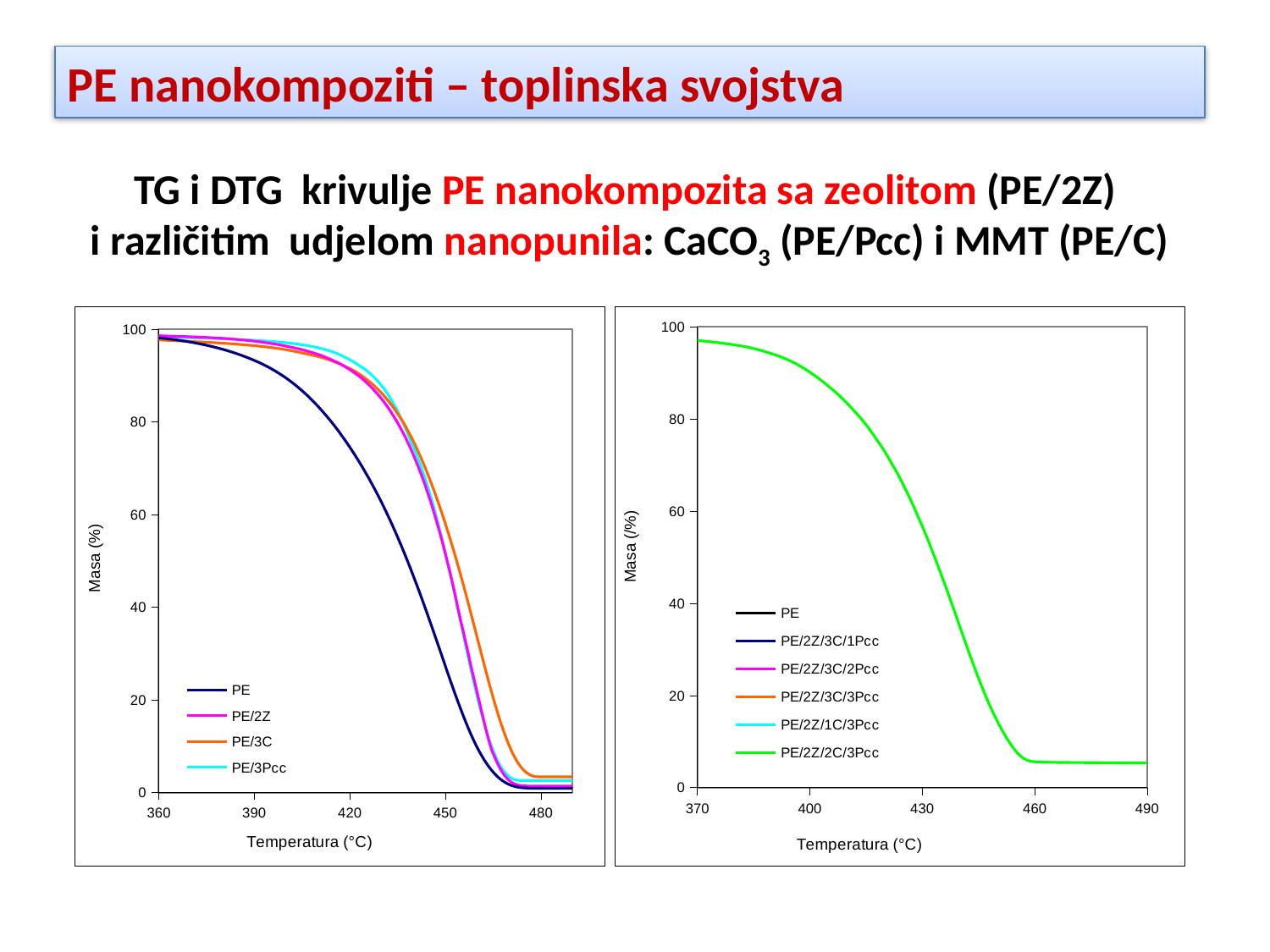
In the left chart, which series has the highest mass at 460 °C? PE/3C In the left chart, which series has the lower mass at 420 °C, PE or PE/2Z? PE How many series does the legend of the left chart list? 4 In the left chart, do the curves rise or fall as temperature increases? fall In the right chart, is the mass at 400 °C greater or less than 80? greater In the left chart, is the mass of PE at 450 °C greater or less than 60? less What is the y-axis label of the left chart? Masa (%) What is the x-axis label of the left chart? Temperatura (°C) How many series does the legend of the right chart list? 6 In the right chart, does the plotted curve rise or fall along the x axis? fall In the right chart, is the mass at 460 °C greater or less than 20? less What kind of chart is the left chart on the slide? line chart